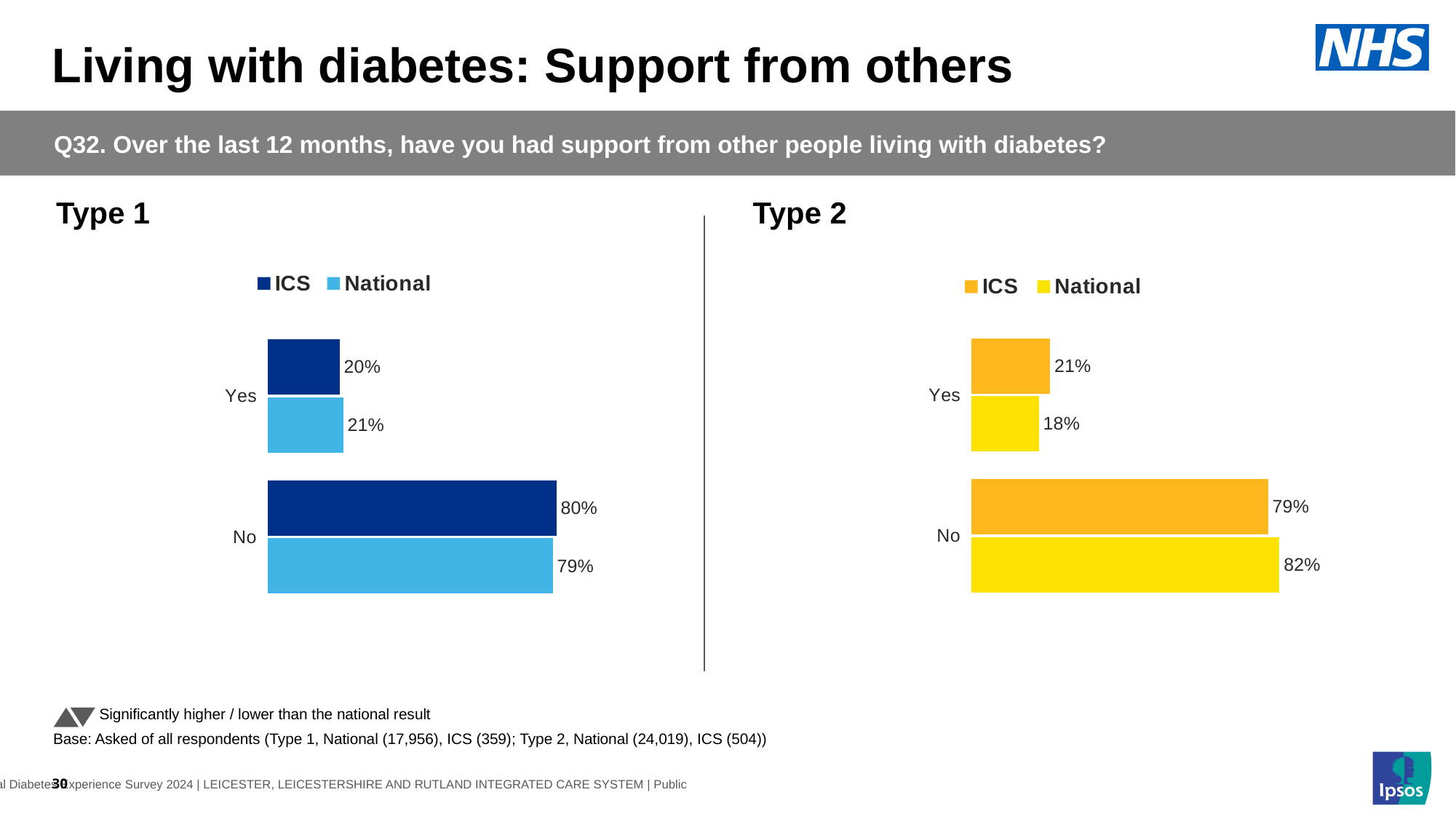
In the Type 1 chart, what is the difference between the ICS and National values for No? 1% What kind of chart is the Type 1 chart? Bar chart In the Type 2 chart, which response category has the lowest National value? Yes In the Type 1 chart, what is the National value for No? 79% In the Type 2 chart, what is the National value for Yes? 18% In the Type 1 chart, which response category has the highest ICS value? No In the Type 1 chart, what is the ICS value for Yes? 20% In the Type 2 chart, what is the difference between the National and ICS values for No? 3% In the Type 2 chart, which is larger for Yes, the ICS value or the National value? ICS How many series does the legend of the Type 1 chart list? 2 How many response categories are shown in the Type 2 chart? 2 In the Type 2 chart, what is the ICS value for No? 79%